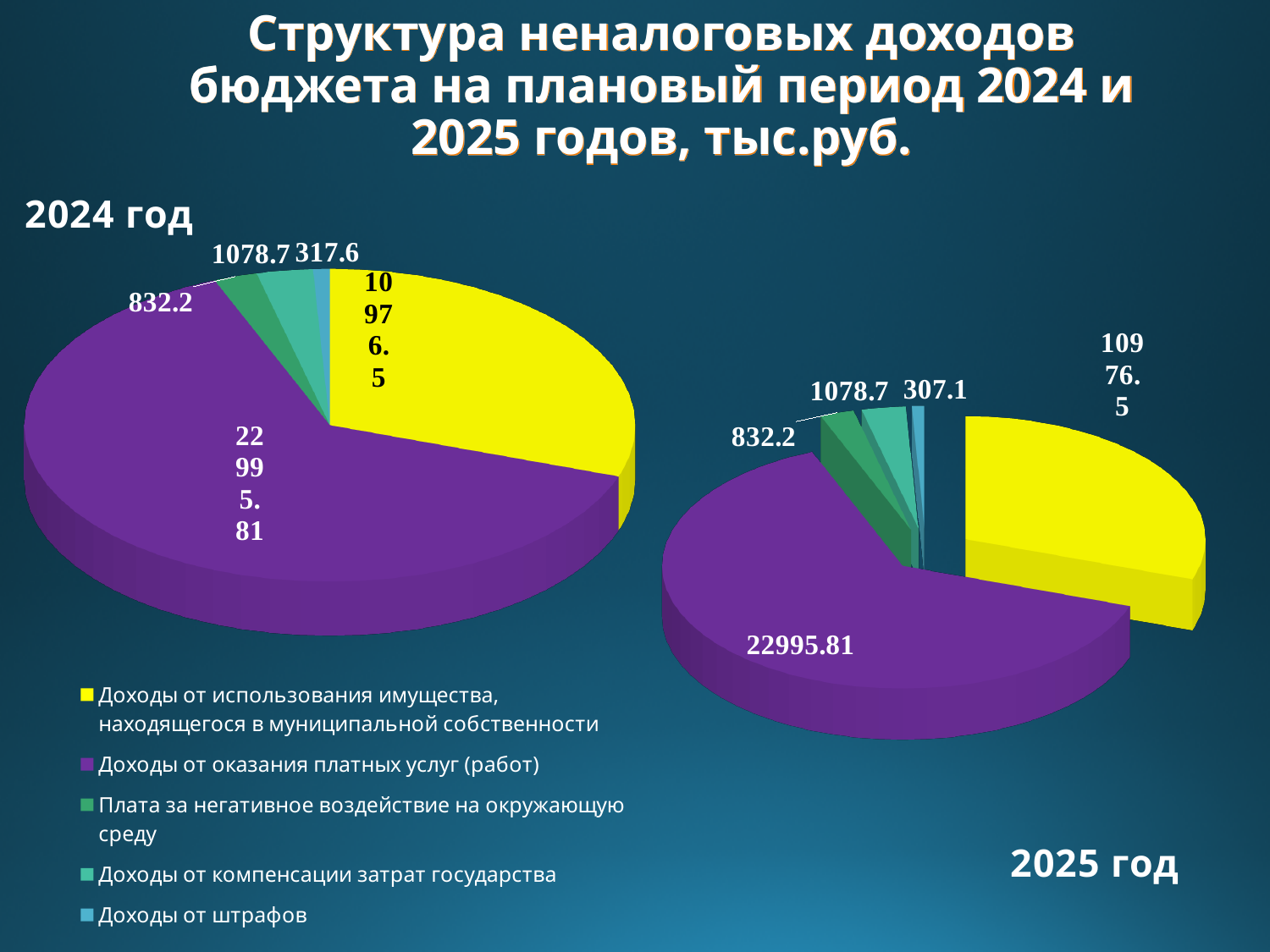
Which colour represents Доходы от оказания платных услуг (работ) in the charts? Purple In the 2024 год chart, which category has the largest slice? Доходы от оказания платных услуг (работ) In the 2024 год chart, what is the value for Доходы от оказания платных услуг (работ)? 22995.81 What is the difference between Доходы от штрафов in the 2024 год chart and in the 2025 год chart? 10.5 In the 2025 год chart, what is the value for Доходы от штрафов? 307.1 In the 2024 год chart, what is the value for Доходы от штрафов? 317.6 In the 2025 год chart, what is the value for Доходы от компенсации затрат государства? 1078.7 In the 2024 год chart, which is larger: Плата за негативное воздействие на окружающую среду or Доходы от компенсации затрат государства? Доходы от компенсации затрат государства How many categories does the legend list? 5 In the 2025 год chart, what is the value for Доходы от использования имущества, находящегося в муниципальной собственности? 10976.5 What kind of charts are shown on the slide? Pie charts In the 2025 год chart, which category has the smallest slice? Доходы от штрафов